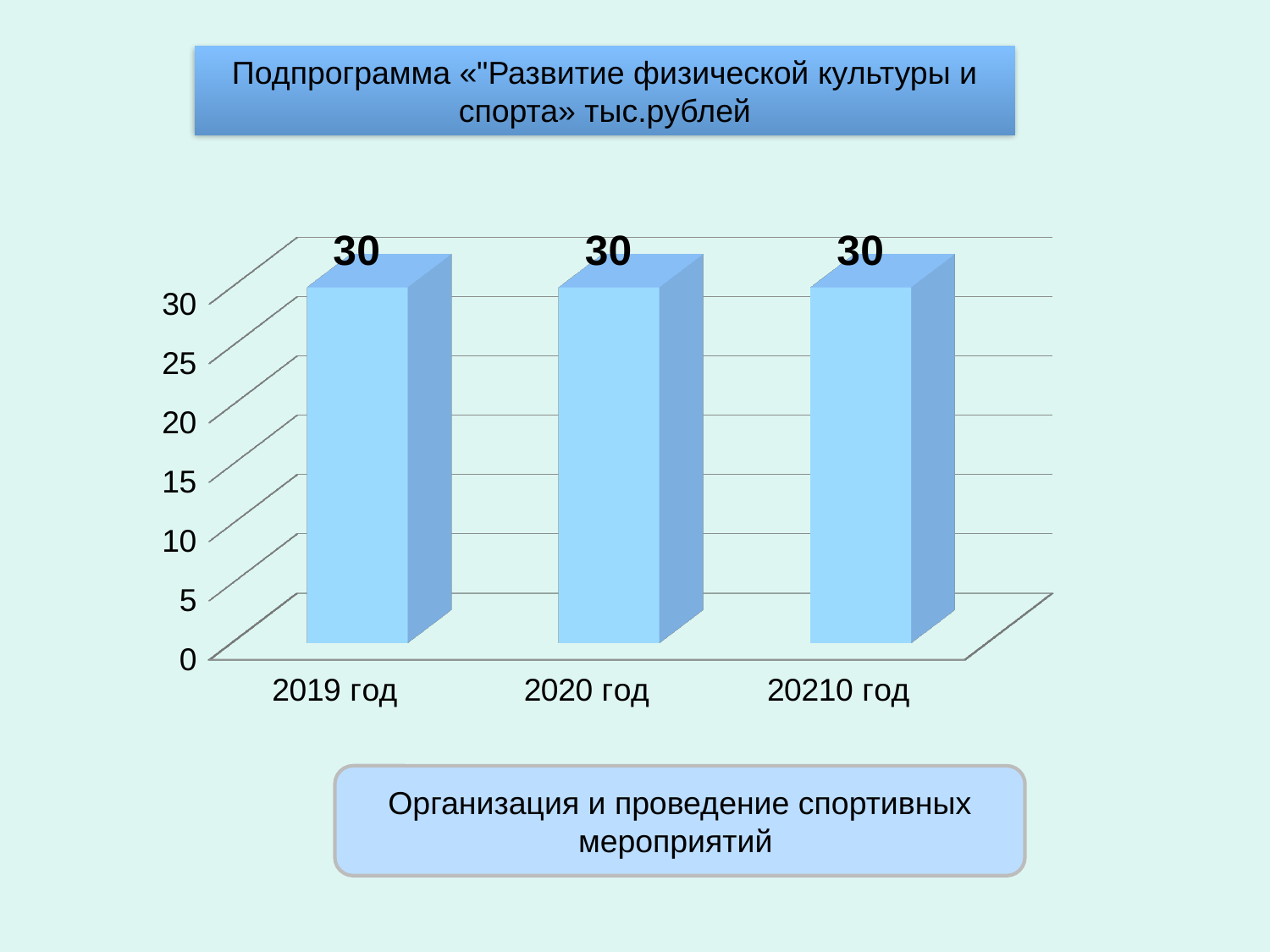
What is the label of the first category on the x axis? 2019 год What is the highest value shown on the vertical axis? 30 What is the value for 20210 год? 30 What is the difference between the values for 2019 год and 2020 год? 0 What is the value for 2019 год? 30 How many categories are shown on the x axis? 3 Do the values rise, fall or stay the same from 2019 год to 20210 год? stay the same Is the value for 2020 год greater or less than 20? greater What is the value for 2020 год? 30 What kind of chart is shown on the slide? bar chart